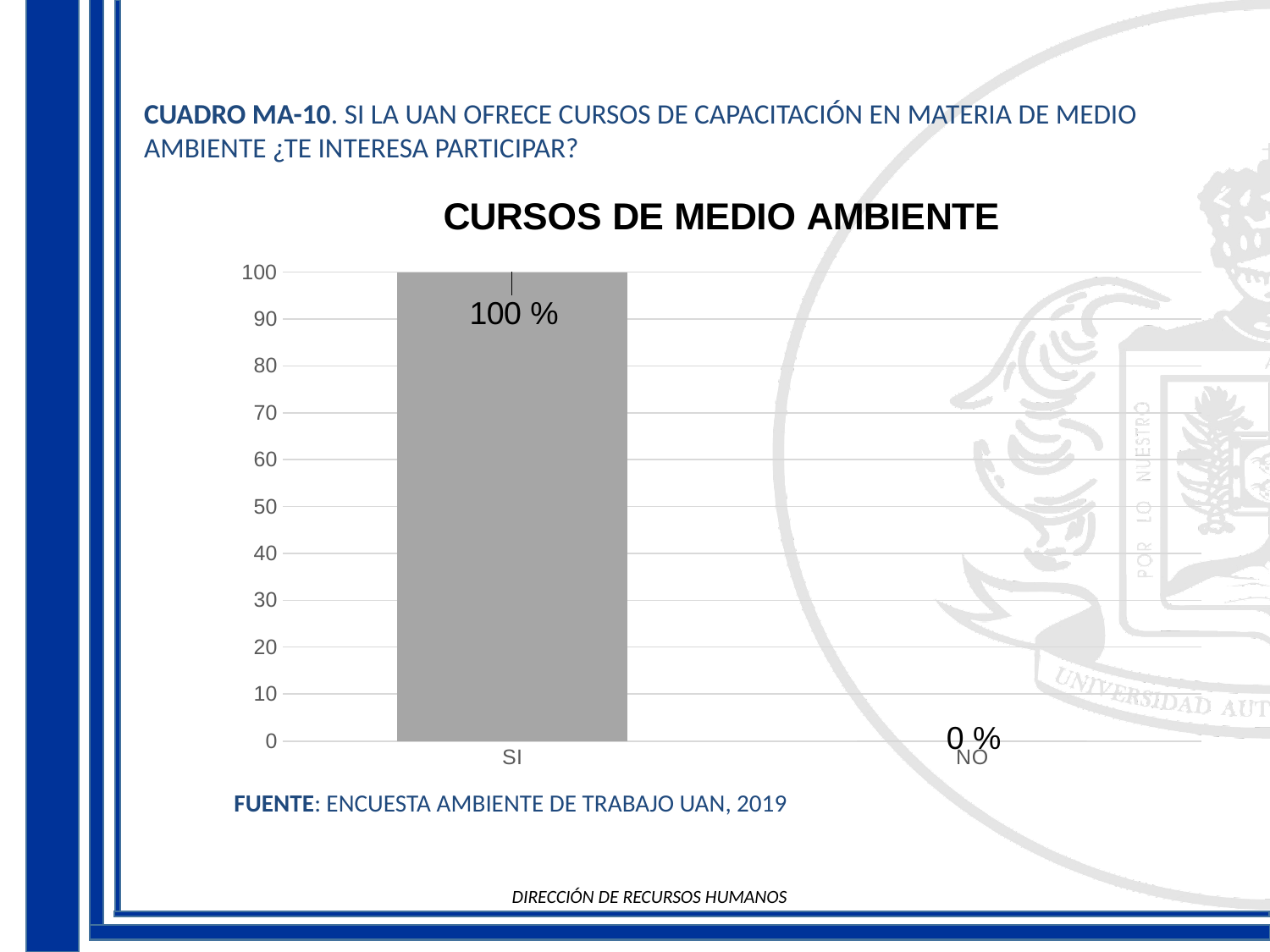
What is the title of the chart? CURSOS DE MEDIO AMBIENTE Is the value for SI greater or less than 50? greater Do the values rise or fall from SI to NO along the x axis? fall What is the value for SI in the CURSOS DE MEDIO AMBIENTE chart? 100 % What is the difference between the values for SI and NO? 100 % What kind of chart is shown on the slide? bar chart How many categories are shown on the x axis of the chart? 2 What is the highest value shown on the y axis of the chart? 100 What is the value for NO in the CURSOS DE MEDIO AMBIENTE chart? 0 % Which category has the lowest value in the chart? NO Which is larger, the value for SI or the value for NO? SI Which category has the highest value in the chart? SI